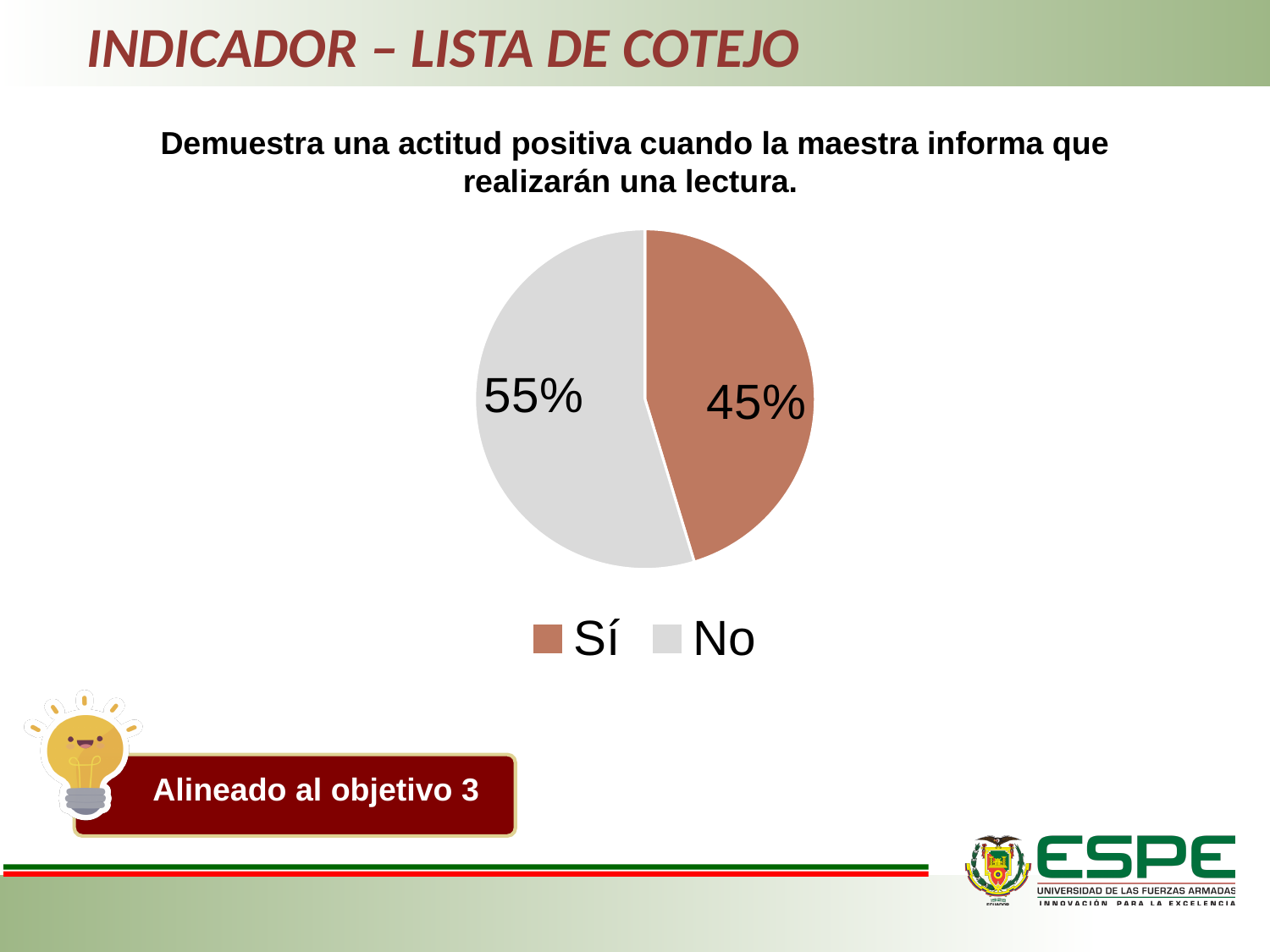
What percentage of the pie chart corresponds to "Sí"? 45% How many slices does the pie chart have? 2 What is the difference in percentage points between the "No" and "Sí" slices? 10 What colour is the "Sí" slice in the pie chart? brown (terracotta) How many entries does the legend list? 2 Which category has the smaller share of the pie chart? Sí Is the share for "Sí" larger or smaller than the share for "No"? smaller What type of chart is shown on the slide? pie chart What share of the pie does the "No" slice represent? 55% What percentage of the pie chart corresponds to "No"? 55% What is the title text above the pie chart? Demuestra una actitud positiva cuando la maestra informa que realizarán una lectura. Which category has the larger share of the pie chart? No